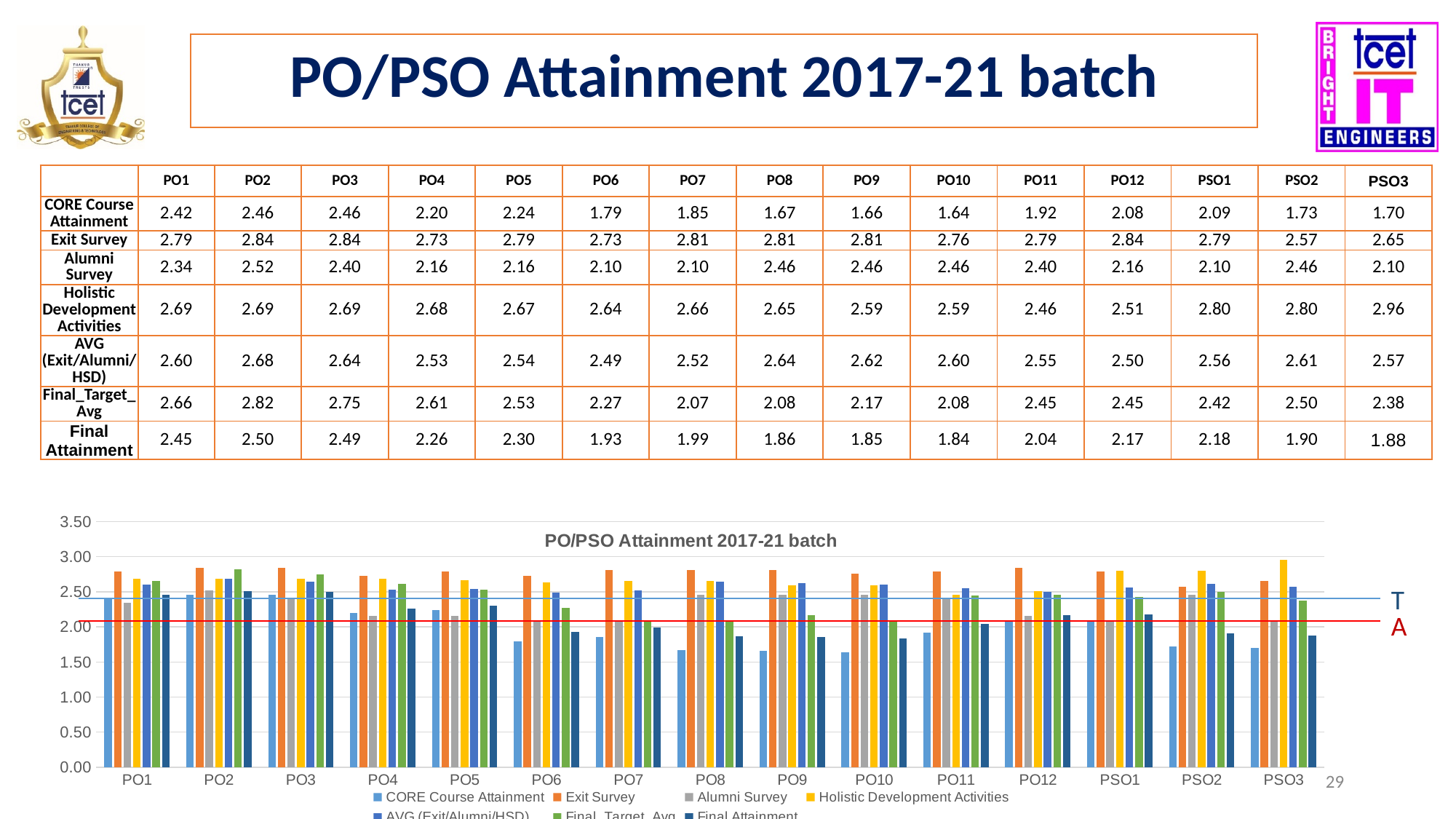
What is the difference between the Exit Survey and CORE Course Attainment values for PO1? 0.37 Is the CORE Course Attainment value for PO8 greater or less than 2.00? less How many categories are shown along the x axis of the chart? 15 For which category is the Holistic Development Activities value highest? PSO3 What type of chart is shown on the slide? bar chart What is the Final Attainment value for PO10? 1.84 What is the title of the chart? PO/PSO Attainment 2017-21 batch For which category is the CORE Course Attainment value lowest? PO10 Which colour represents the Exit Survey series in the chart? orange How many series does the chart legend list? 7 Which is larger for PO6: the Exit Survey value or the Alumni Survey value? Exit Survey What is the Exit Survey value for PSO1? 2.79